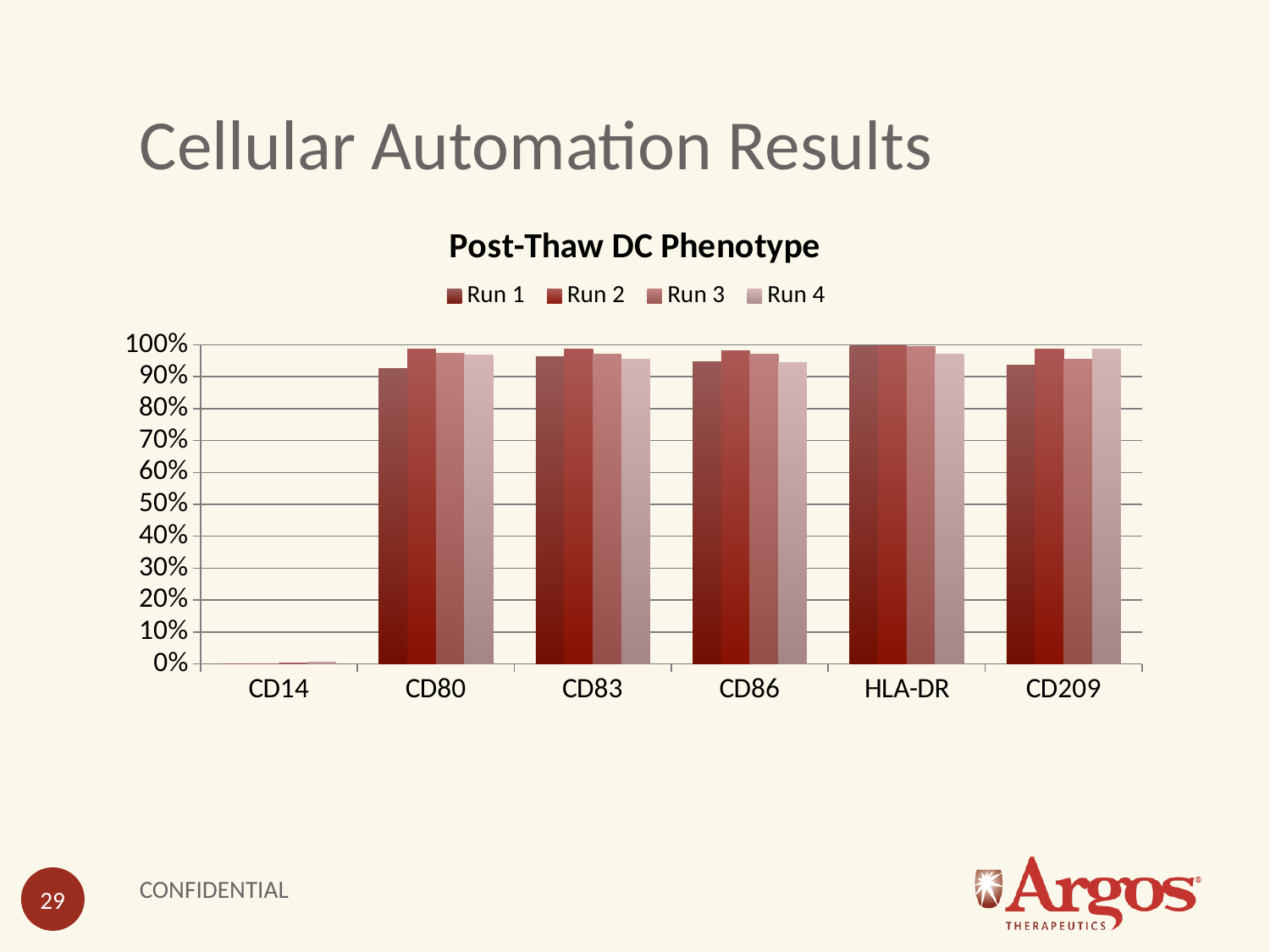
Is the Run 1 value for CD80 greater or less than 90%? greater What is the highest value shown on the y axis? 100% What kind of chart is shown on the slide? bar chart Is the Run 1 value for CD14 greater or less than 10%? less Which category has the lowest values across all runs? CD14 Is the Run 4 value for CD86 greater or less than 80%? greater How many categories are shown on the x axis? 6 What are the names of the series listed in the legend? Run 1, Run 2, Run 3, Run 4 How many series does the legend list? 4 What is the title of the chart? Post-Thaw DC Phenotype For Run 1, which is larger: the value for CD14 or the value for CD209? CD209